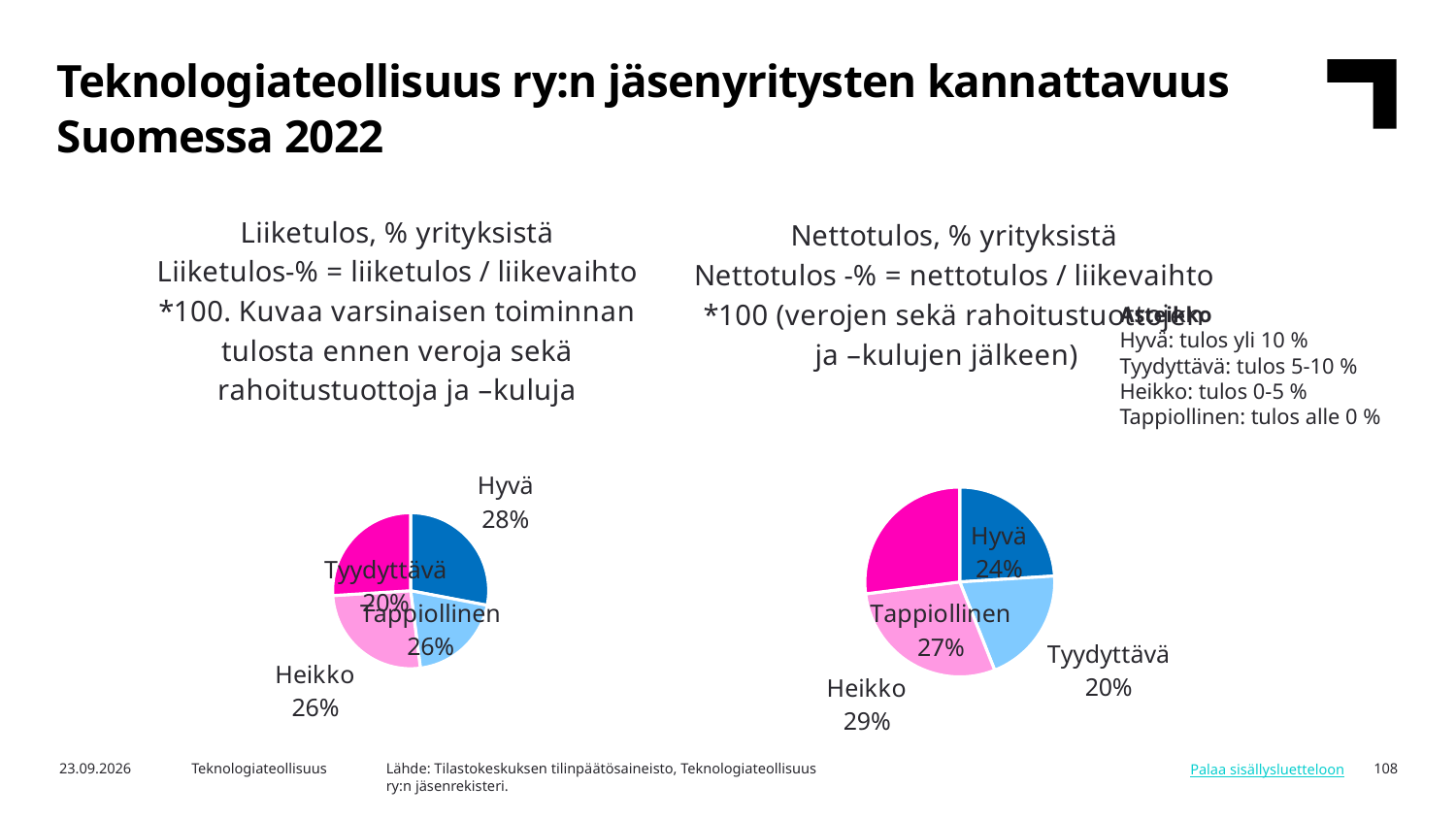
In the left pie chart (Liiketulos, % yrityksistä), what share of companies is labelled Hyvä? 28% In the right pie chart (Nettotulos, % yrityksistä), what share of companies is labelled Heikko? 29% What type of chart is used on this slide? Pie chart In the right pie chart (Nettotulos, % yrityksistä), what is the difference between the Heikko share and the Hyvä share? 5 percentage points In the left pie chart (Liiketulos, % yrityksistä), what share of companies is labelled Heikko? 26% In the left pie chart (Liiketulos, % yrityksistä), which category has the largest share? Hyvä In the right pie chart (Nettotulos, % yrityksistä), which category has the smallest share? Tyydyttävä In the right pie chart (Nettotulos, % yrityksistä), which category has the largest share? Heikko Which is larger: the Hyvä share in the left pie chart (Liiketulos) or the Hyvä share in the right pie chart (Nettotulos)? Left pie chart (Liiketulos), 28% In the right pie chart (Nettotulos, % yrityksistä), what share of companies is labelled Tappiollinen? 27% In the left pie chart (Liiketulos, % yrityksistä), what share of companies is labelled Tyydyttävä? 20% In the left pie chart (Liiketulos, % yrityksistä), which category has the smallest share? Tyydyttävä